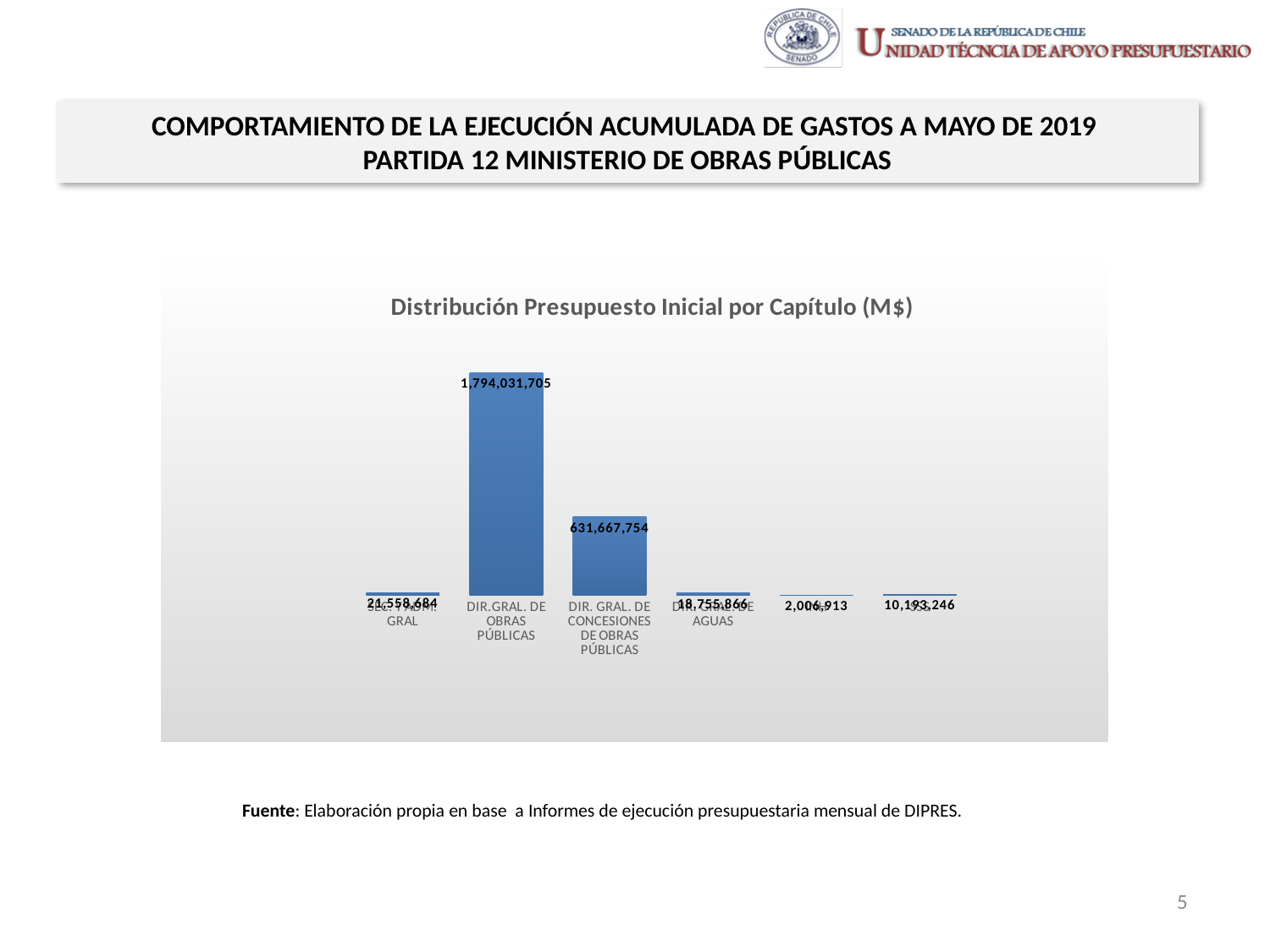
Which capítulo has the highest initial budget? DIR.GRAL. DE OBRAS PÚBLICAS What is the value for DIR. GRAL. DE AGUAS? 18,755,866 What is the value for DIR. GRAL. DE CONCESIONES DE OBRAS PÚBLICAS? 631,667,754 What kind of chart is shown on the slide? bar chart What is the value for DIR.GRAL. DE OBRAS PÚBLICAS? 1,794,031,705 What unit is indicated in the chart title for the values? M$ What is the value of the last (rightmost) bar in the chart? 10,193,246 What is the smallest value shown in the chart? 2,006,913 Which is larger, the value for DIR. GRAL. DE CONCESIONES DE OBRAS PÚBLICAS or the value for DIR. GRAL. DE AGUAS? DIR. GRAL. DE CONCESIONES DE OBRAS PÚBLICAS How many bars (capítulos) are plotted in the chart? 6 What is the difference between the values for DIR.GRAL. DE OBRAS PÚBLICAS and DIR. GRAL. DE CONCESIONES DE OBRAS PÚBLICAS? 1,162,363,951 What is the title of the chart? Distribución Presupuesto Inicial por Capítulo (M$)